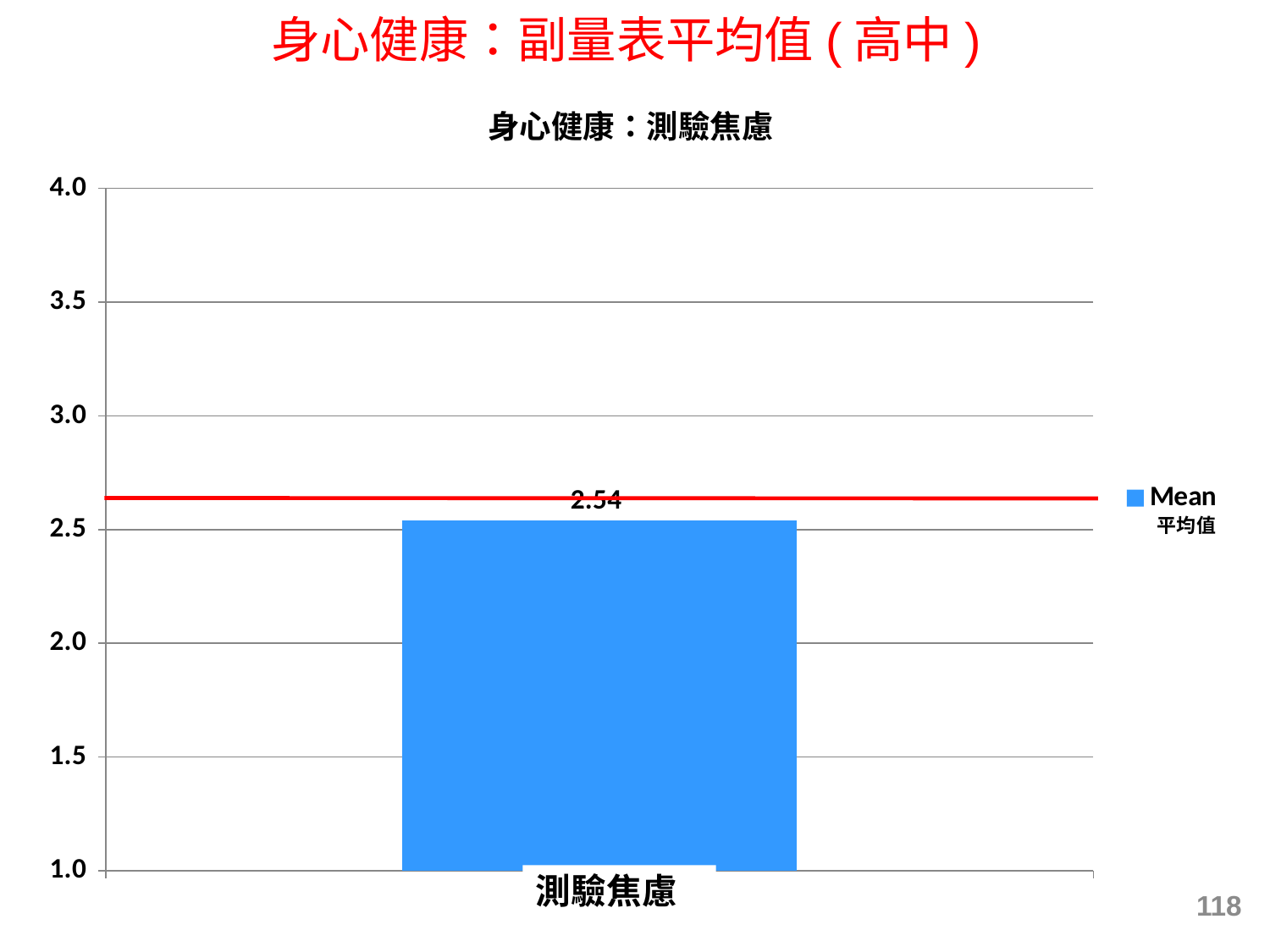
What is the value of the bar for 測驗焦慮? 2.54 Is the value for 測驗焦慮 greater or less than 2.5? greater What kind of chart is shown on the slide? bar chart Does the top of the 測驗焦慮 bar lie above or below the red horizontal line? below Is the value for 測驗焦慮 greater or less than 3.0? less How many series does the legend list? 1 What series name is shown in the legend? Mean 平均值 What is the title of the chart? 身心健康：測驗焦慮 Is the value for 測驗焦慮 greater or less than 2.0? greater What is the highest value shown on the vertical axis? 4.0 How many bars are plotted in the chart? 1